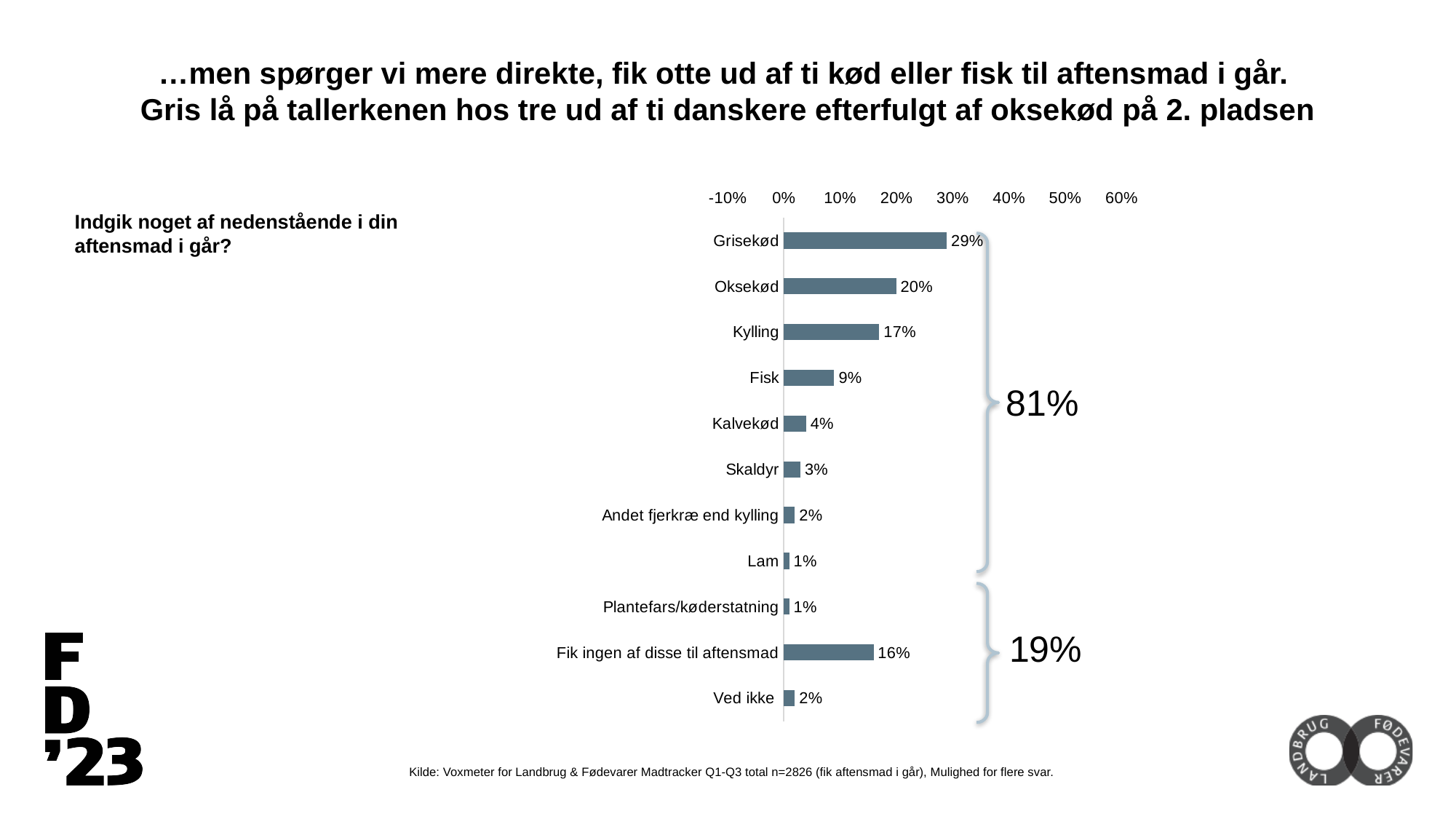
Is the value for Oksekød greater or less than 10%? greater What percentage is shown next to the upper bracket grouping Grisekød through Lam? 81% What is the value for Kalvekød? 4% What is the difference between the values for Fik ingen af disse til aftensmad and Ved ikke? 14% What is the difference between the values for Grisekød and Oksekød? 9% What is the value for Grisekød? 29% What is the value for Kylling? 17% What kind of chart is shown on the slide? bar chart Which category has the highest value? Grisekød How many categories are shown in the chart? 11 Which is larger, the value for Fisk or the value for Kylling? Kylling What is the value for Fik ingen af disse til aftensmad? 16%